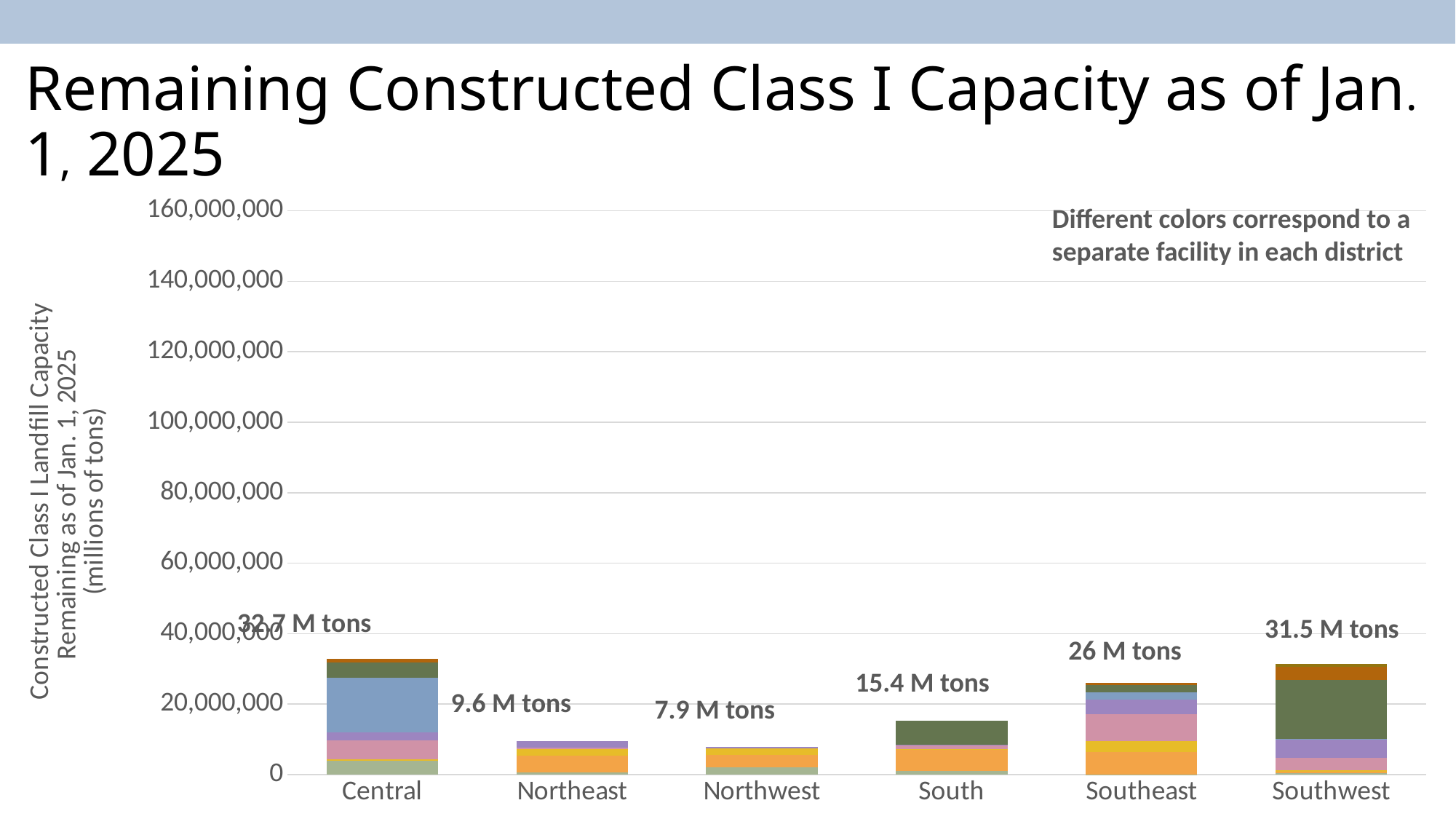
What is the total remaining capacity labeled for the Southeast district? 26 M tons Which district has a larger total remaining capacity, Northeast or South? South What is the total remaining capacity labeled for the Northwest district? 7.9 M tons Which district has the highest total remaining capacity? Central Is the total for the Southwest district greater or less than 20,000,000? greater According to the note on the chart, what do the different colors in each bar represent? A separate facility in each district What is the difference between the labeled totals for Southeast and South? 10.6 M tons Which district has the lowest total remaining capacity? Northwest What is the difference between the labeled totals for Central and Southwest? 1.2 M tons What is the total remaining capacity labeled for the Central district? 32.7 M tons What kind of chart is shown on the slide? Stacked bar chart How many districts are shown on the x axis? 6